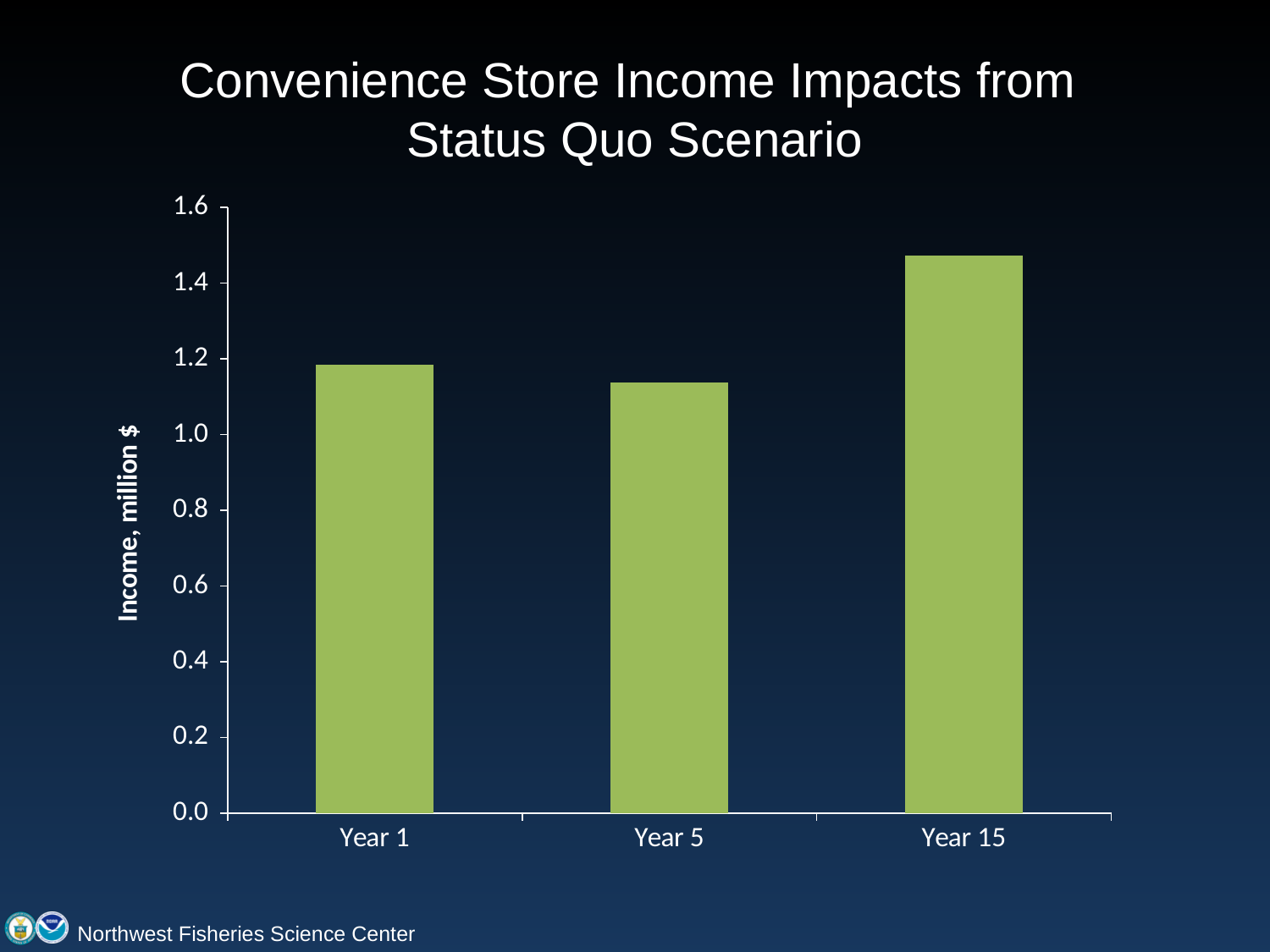
What kind of chart is shown on the slide? Bar chart What is the label on the vertical axis of the chart? Income, million $ Is the value for Year 15 greater or less than 1.4? greater How many categories (years) are plotted on the chart? 3 Which is larger, the value for Year 1 or the value for Year 5? Year 1 Is the value for Year 1 greater or less than 1.0? greater Is the value for Year 15 greater or less than 1.6? less Which year has the lowest convenience store income impact? Year 5 Which is larger, the value for Year 15 or the value for Year 1? Year 15 Which year has the highest convenience store income impact? Year 15 Do the values rise steadily from Year 1 to Year 15, or do they dip before rising? They dip at Year 5 before rising at Year 15